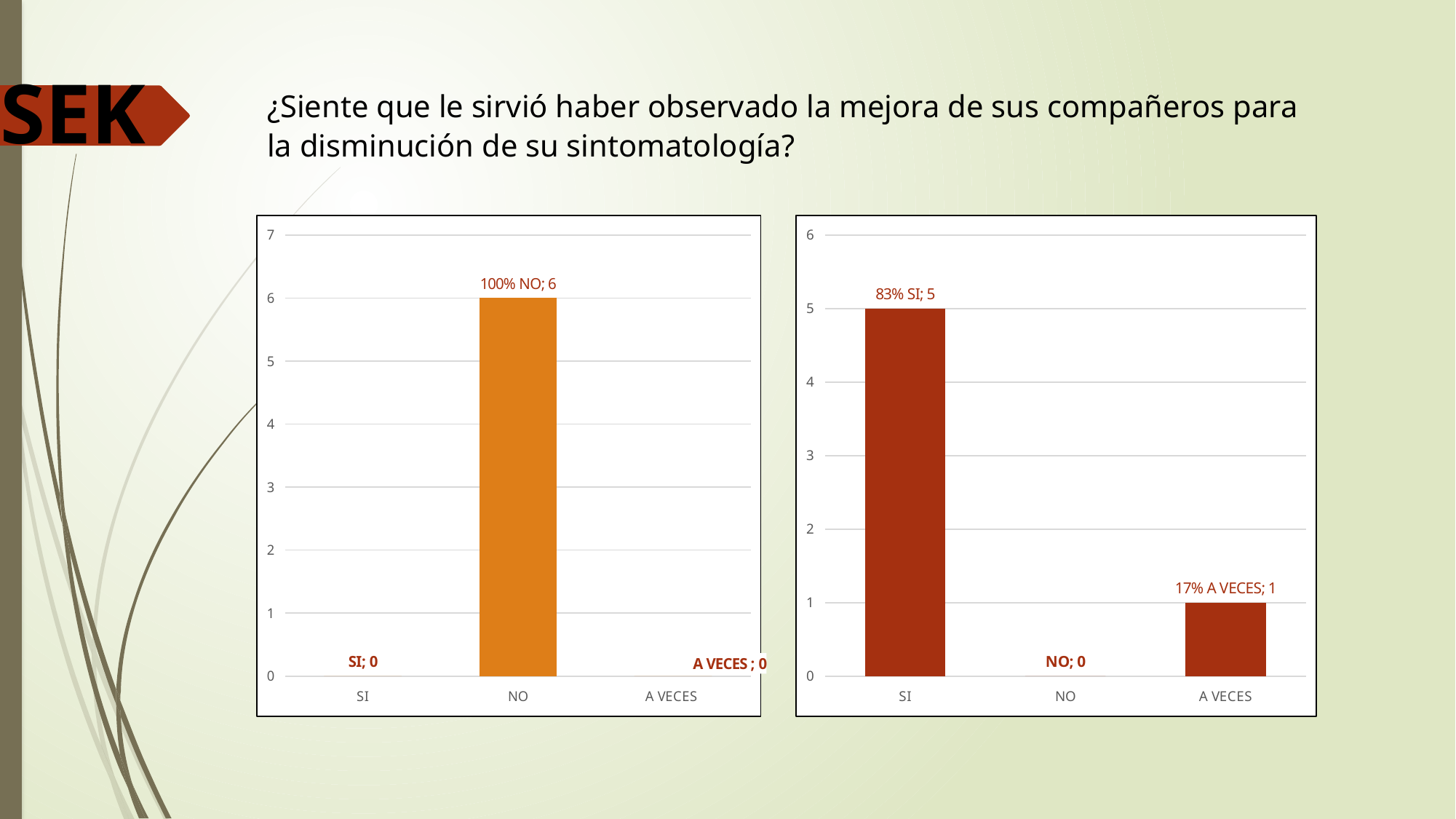
In the left chart, what is the value for NO? 6 What kind of chart is the right chart? Bar chart In the right chart, what is the value for NO? 0 In the left chart, which category has the highest value? NO In the right chart, which category has the lowest value? NO In the right chart, what is the difference between the values for SI and A VECES? 4 How many categories are shown on the x axis of the left chart? 3 In the right chart, which is larger, the value for SI or the value for A VECES? SI In the right chart, what is the value for SI? 5 In the left chart, what is the value for SI? 0 In the right chart, which category has the highest value? SI In the right chart, what is the value for A VECES? 1